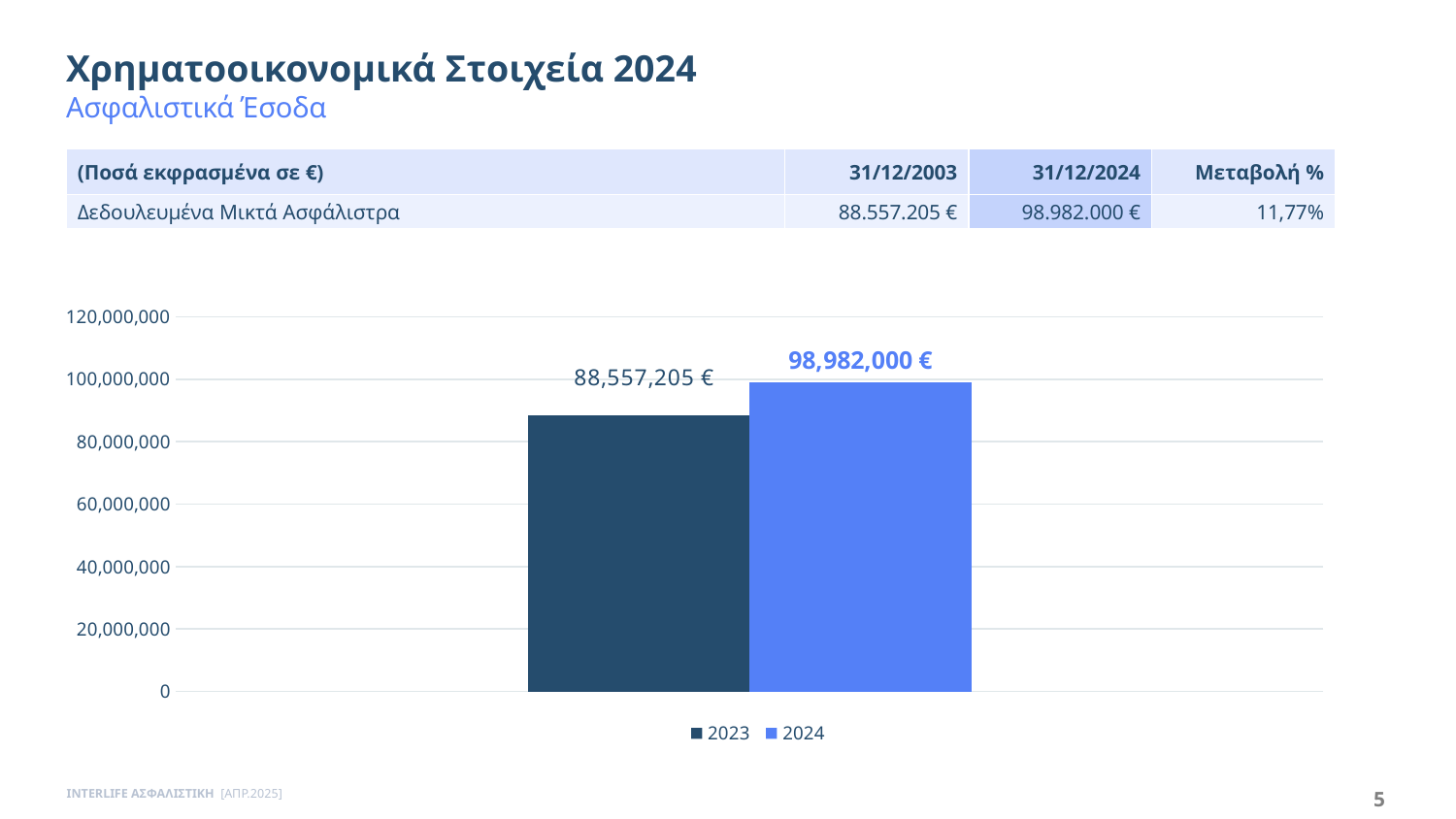
Is the value for 2024 greater or less than 80,000,000? greater What is the value shown for the 2023 bar in the chart? 88,557,205 € Which series has the lowest value in the chart? 2023 Which series has the highest value in the chart? 2024 Which series has the higher bar in the chart, 2023 or 2024? 2024 How many bars are plotted in the chart? 2 Is the value for 2023 greater or less than 100,000,000? less What is the value shown for the 2024 bar in the chart? 98,982,000 € What kind of chart is shown on the slide? bar chart What is the difference between the 2024 and 2023 values in the chart? 10,424,795 € How many series does the chart legend list? 2 What is the highest value shown on the chart's vertical axis? 120,000,000